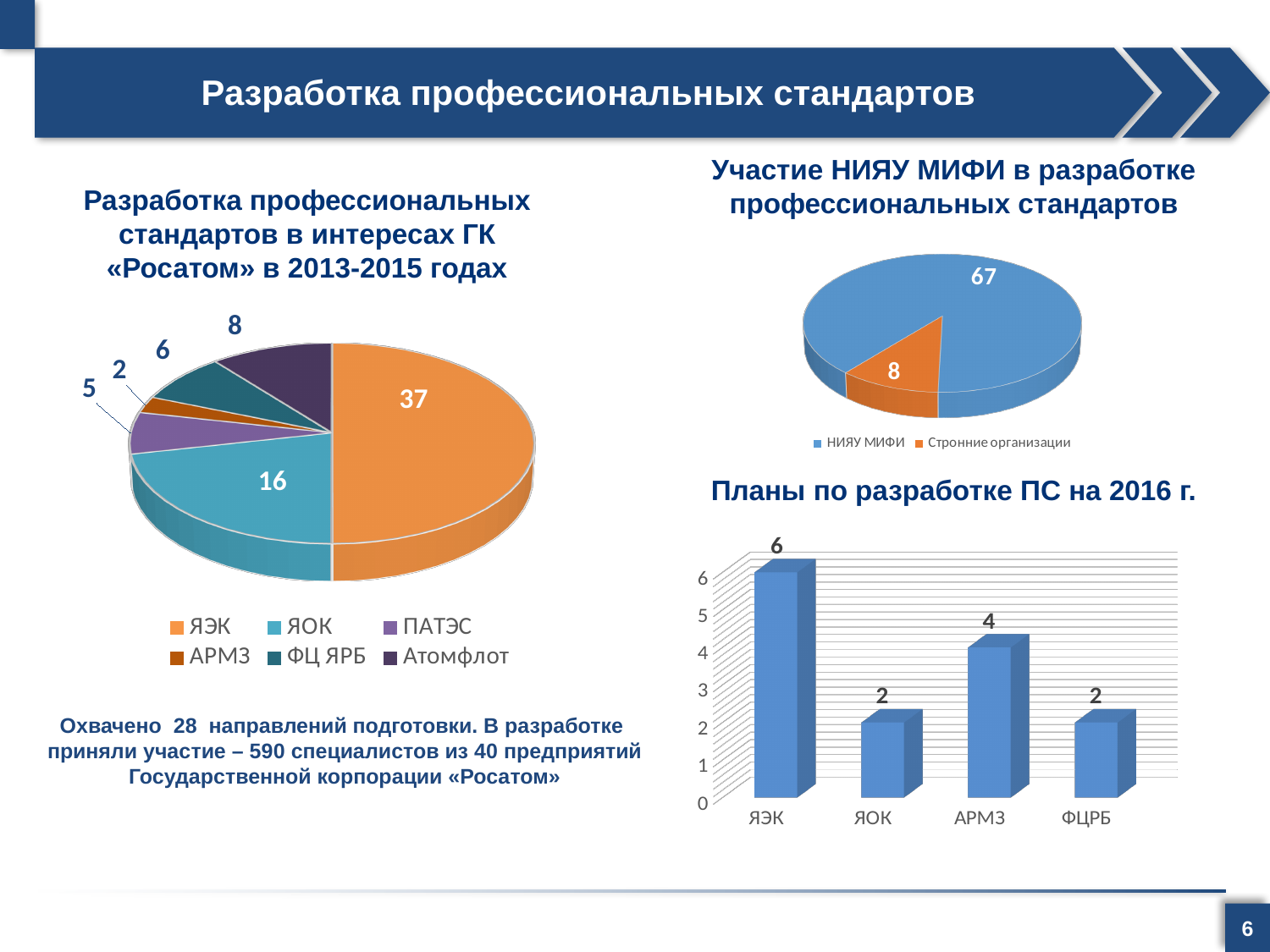
In the pie chart 'Разработка профессиональных стандартов в интересах ГК «Росатом» в 2013-2015 годах', which category has the smallest slice? АРМЗ In the pie chart 'Разработка профессиональных стандартов в интересах ГК «Росатом» в 2013-2015 годах', what share of the total does ЯЭК represent? 50% In the chart 'Планы по разработке ПС на 2016 г.', what is the difference between ЯЭК and ЯОК? 4 In the pie chart 'Разработка профессиональных стандартов в интересах ГК «Росатом» в 2013-2015 годах', what is the value for ЯЭК? 37 In the pie chart 'Участие НИЯУ МИФИ в разработке профессиональных стандартов', what is the difference between НИЯУ МИФИ and Сторонние организации? 59 In the pie chart 'Участие НИЯУ МИФИ в разработке профессиональных стандартов', what is the value for НИЯУ МИФИ? 67 In the chart 'Планы по разработке ПС на 2016 г.', which category has the highest value? ЯЭК In the pie chart 'Разработка профессиональных стандартов в интересах ГК «Росатом» в 2013-2015 годах', how many categories does the legend list? 6 In the chart 'Планы по разработке ПС на 2016 г.', what is the value for АРМЗ? 4 In the pie chart 'Участие НИЯУ МИФИ в разработке профессиональных стандартов', what is the value for Сторонние организации? 8 In the pie chart 'Разработка профессиональных стандартов в интересах ГК «Росатом» в 2013-2015 годах', what is the value for ЯОК? 16 What kind of chart is 'Планы по разработке ПС на 2016 г.'? Bar chart